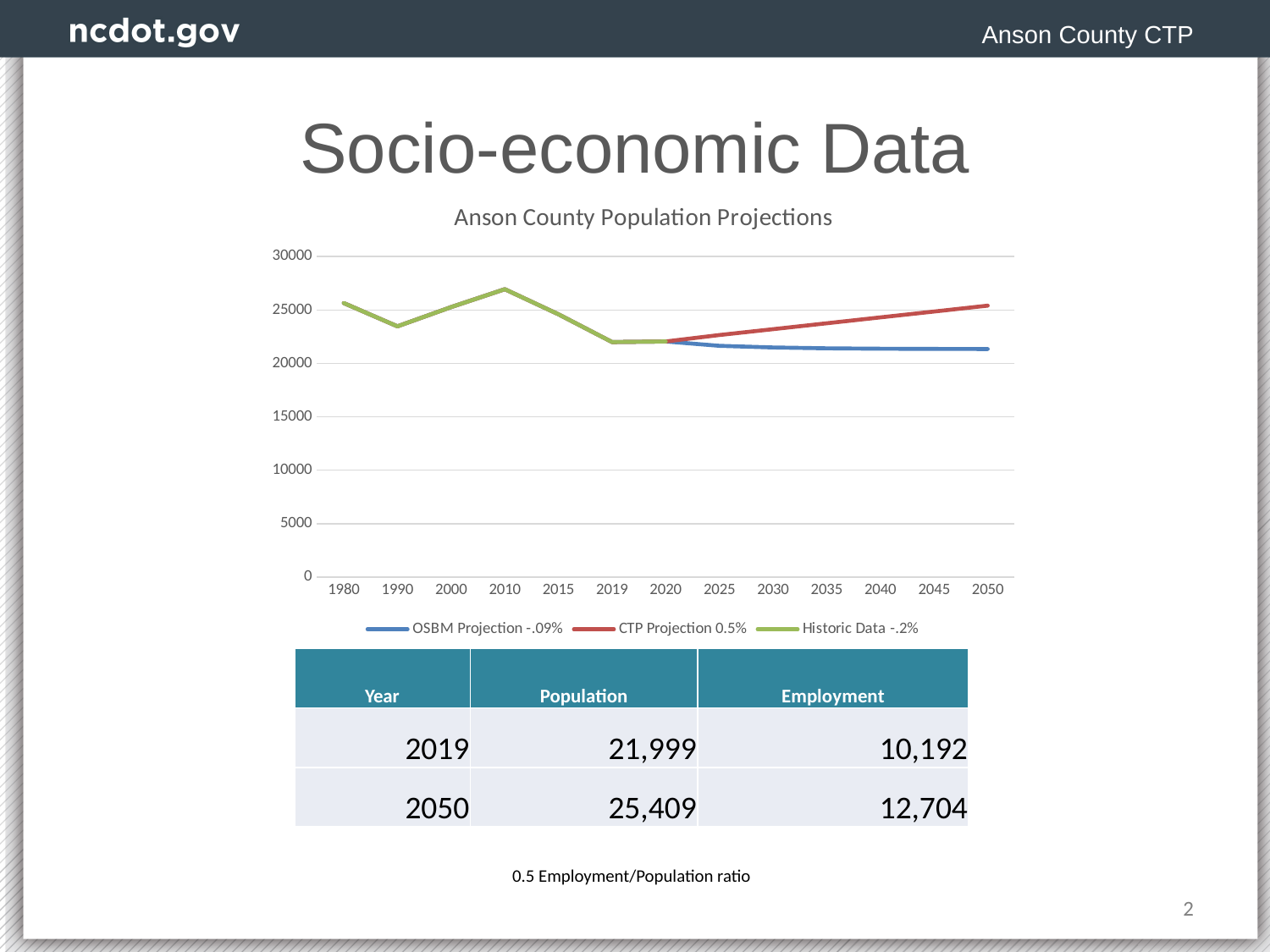
What is the title of the chart? Anson County Population Projections In which year does the Historic Data series reach its highest value? 2010 Which series is drawn in red in the chart? CTP Projection 0.5% How many series does the chart legend list? 3 Is the Historic Data value for 2010 greater or less than 25000? greater What kind of chart is shown on the slide? line chart Is the Historic Data value for 2019 greater or less than 25000? less Does the OSBM Projection -.09% series rise or fall from 2020 to 2050? fall Is the Historic Data value for 1990 greater or less than 25000? less How many year labels are shown along the x axis of the chart? 13 At 2050, which series has the larger value, CTP Projection 0.5% or OSBM Projection -.09%? CTP Projection 0.5%